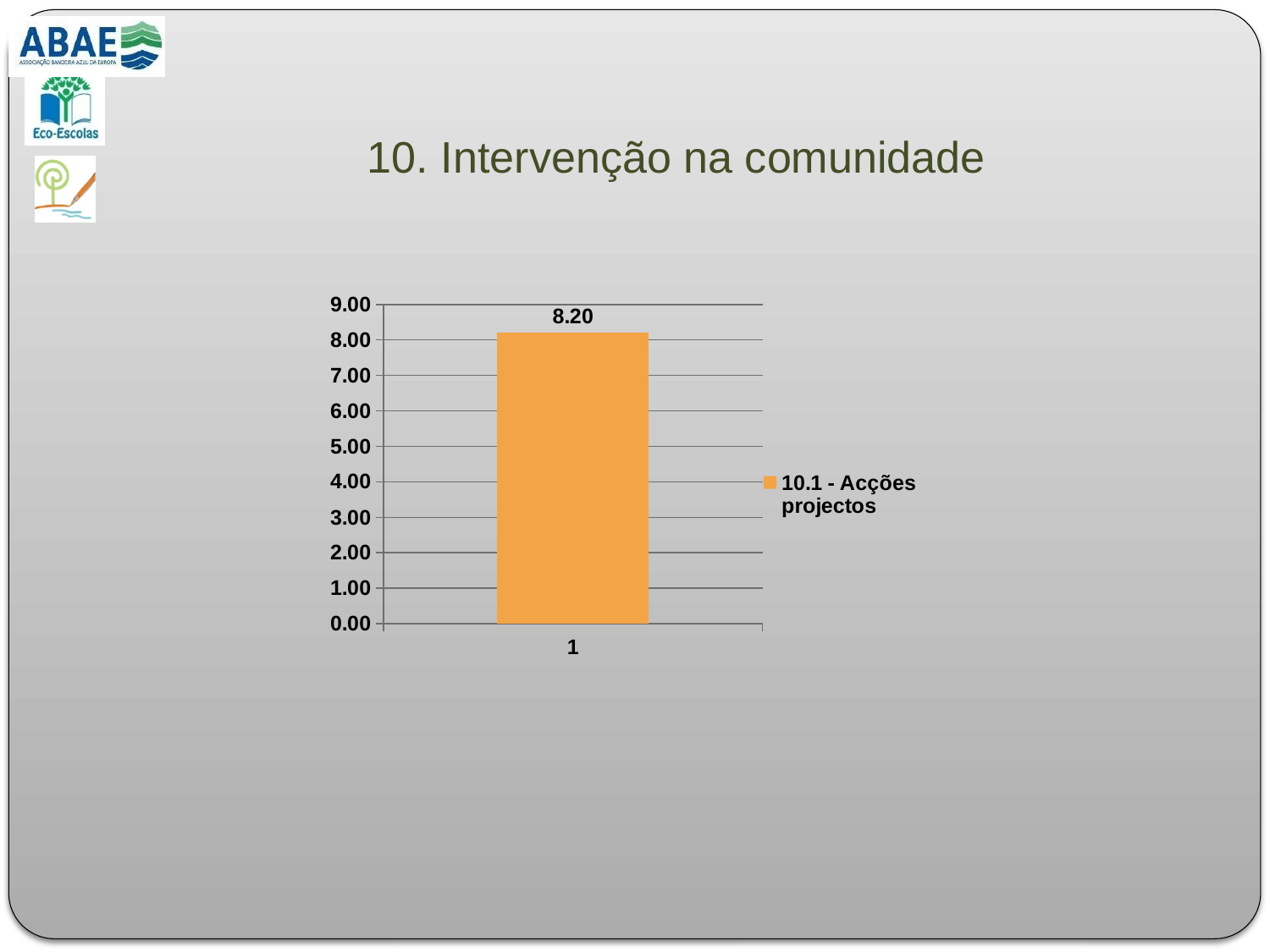
What is the name of the series shown in the legend? 10.1 - Acções projectos Is the value for category 1 greater or less than 8.00? greater What is the value of the bar for series "10.1 - Acções projectos"? 8.20 What is the maximum value shown on the y axis? 9.00 How many bars are plotted in the chart? 1 What is the title of the slide containing the chart? 10. Intervenção na comunidade What kind of chart is shown on the slide? bar chart Is the value for category 1 greater or less than 9.00? less What is the category label shown on the x axis? 1 How many series does the legend list? 1